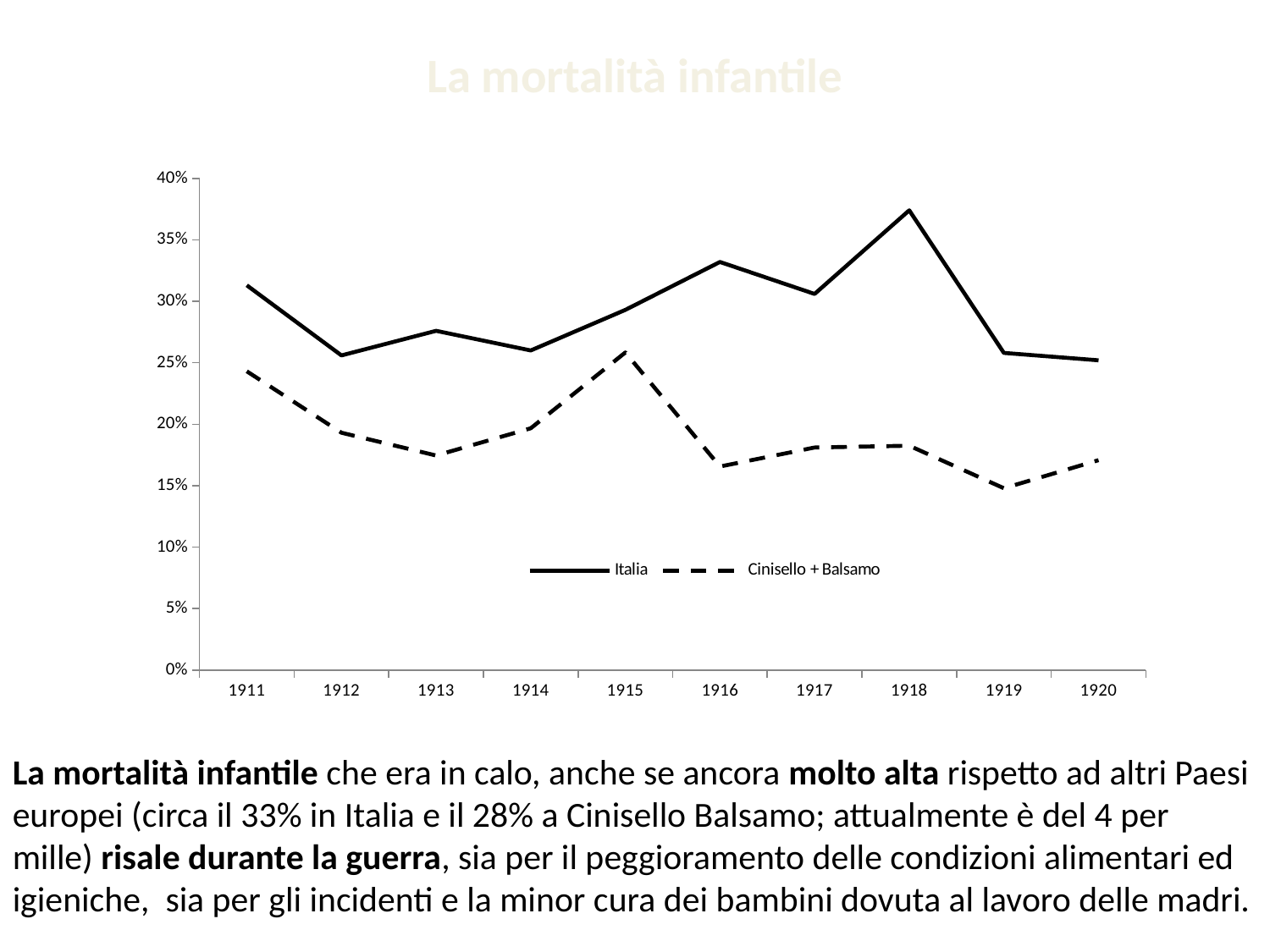
In which year does the Cinisello + Balsamo series reach its lowest value? 1919 In which year does the Italia series reach its highest value? 1918 What kind of chart is shown on the slide? Line chart How many series does the legend list? 2 Is the value for Italia in 1918 greater or less than 35%? greater Does the Italia series rise or fall from 1918 to 1920? Fall Is the value for Cinisello + Balsamo in 1916 greater or less than 20%? less Which series is drawn with a dashed line? Cinisello + Balsamo In 1915, which series has the higher value, Italia or Cinisello + Balsamo? Italia How many years are plotted along the x axis? 10 Is the value for Italia in 1911 greater or less than 30%? greater In which year does the Cinisello + Balsamo series reach its highest value? 1915